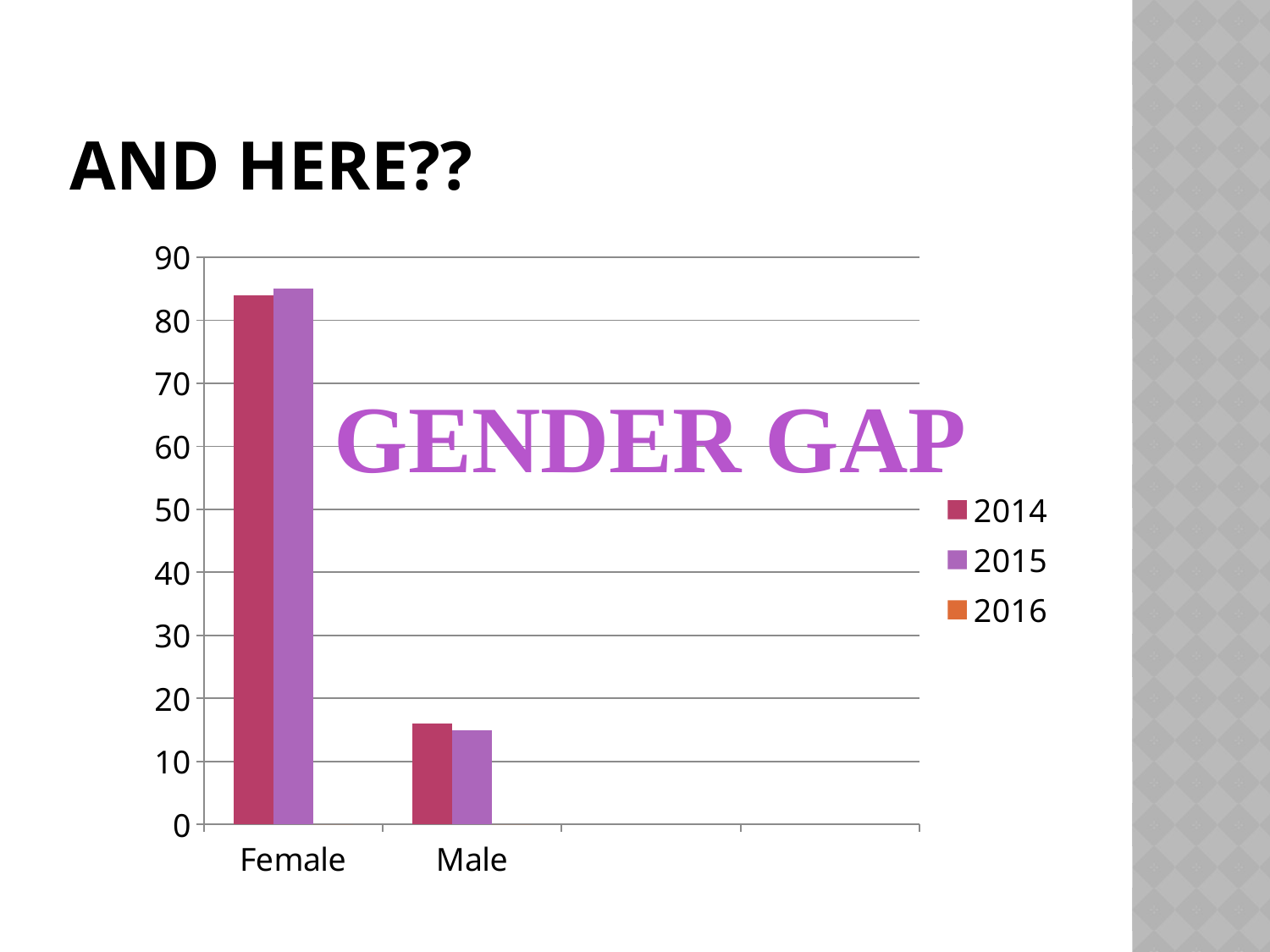
Is the 2015 value for Male greater or less than 10? greater Which category has the highest values in the chart? Female Is the 2014 value for Male greater or less than 20? less What kind of chart is shown on the slide? bar chart How many categories are shown on the x axis of the chart? 2 Is the 2015 value for Female greater or less than 90? less Which years are listed in the chart legend? 2014, 2015, 2016 Which category has the lowest values in the chart? Male What text is overlaid in large purple letters on the chart? GENDER GAP Which is larger, the 2015 value for Female or the 2015 value for Male? Female How many series does the chart legend list? 3